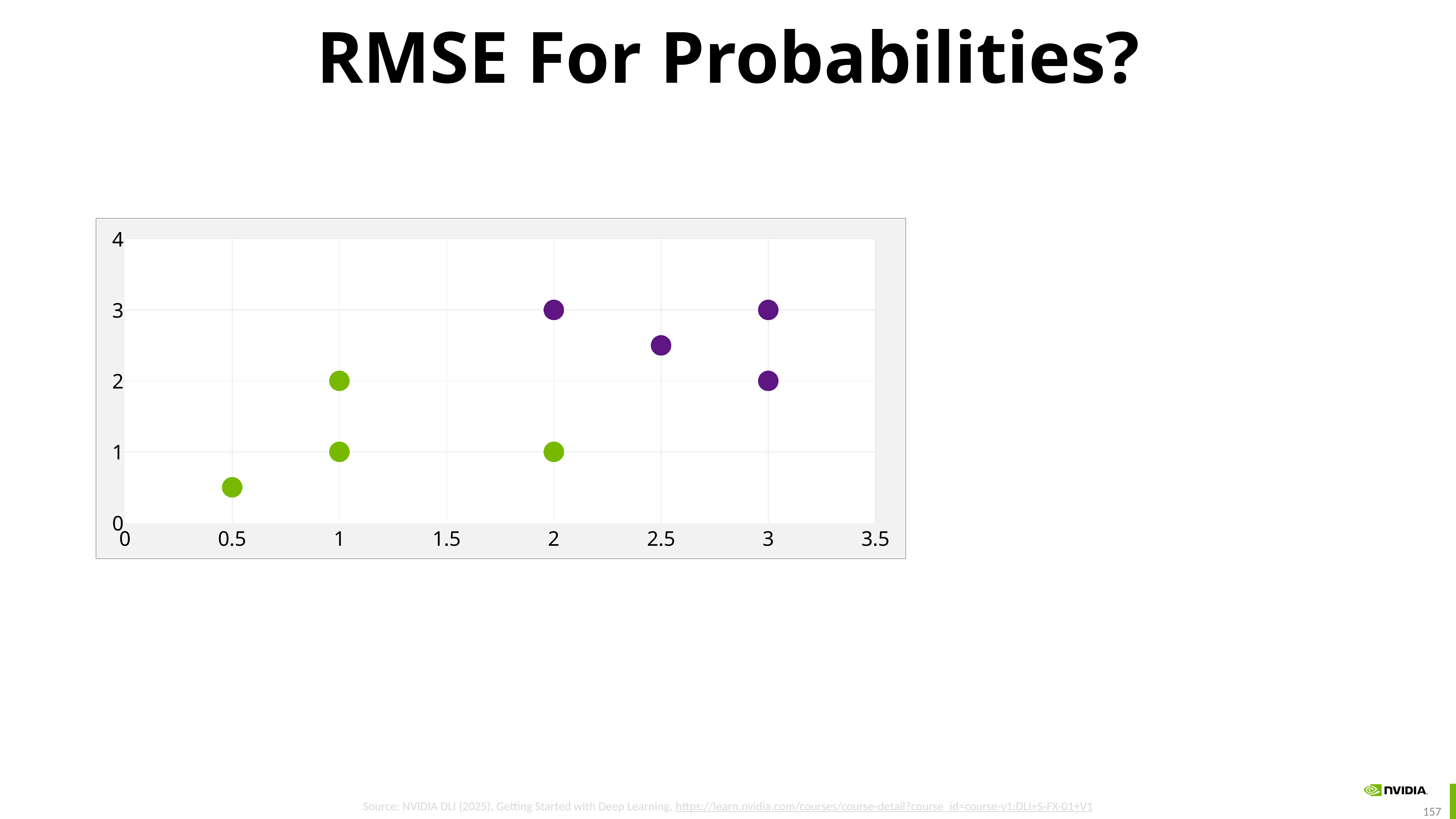
How many data points are plotted on the chart? 8 What is the highest y value reached by any green point? 2 Is the y value of the green point at x = 0.5 greater or less than 1? less How many green points are plotted on the chart? 4 What is the y value of the purple point at x = 2? 3 How many purple points are plotted on the chart? 4 What kind of chart is shown on the slide? scatter plot What are the y values of the two purple points at x = 3? 3 and 2 Which colour of points has the highest y value on the chart? purple What is the largest value shown on the x axis? 3.5 Is the y value of the purple point at x = 2.5 greater or less than 2? greater What is the y value of the green point at x = 2? 1